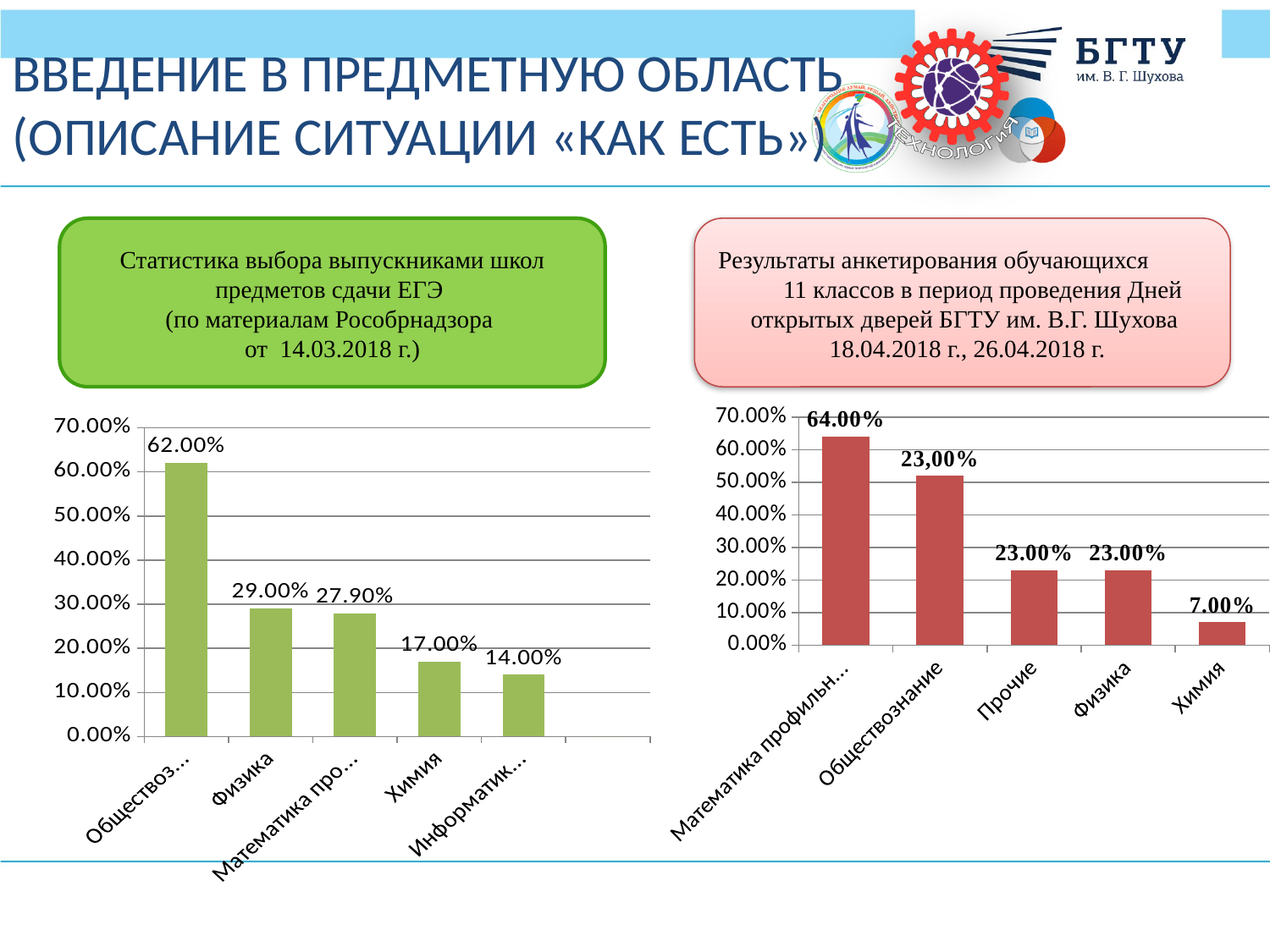
On the right chart, what is the value for Химия? 7.00% On the left chart, what is the difference between the values for Физика and Химия? 12.00% On the left chart, what is the lowest value shown? 14.00% On the right chart, what is the highest value shown? 64.00% On the left chart, how many bars are plotted? 5 On the right chart, what is the value for Физика? 23.00% On the left chart, what is the value for Физика? 29.00% On the right chart, which category has the lowest value? Химия On the left chart, what is the highest value shown? 62.00% On the right chart, which is larger: the value for Прочие or the value for Химия? Прочие What kind of chart is the right chart? bar chart On the left chart, what is the value for Химия? 17.00%